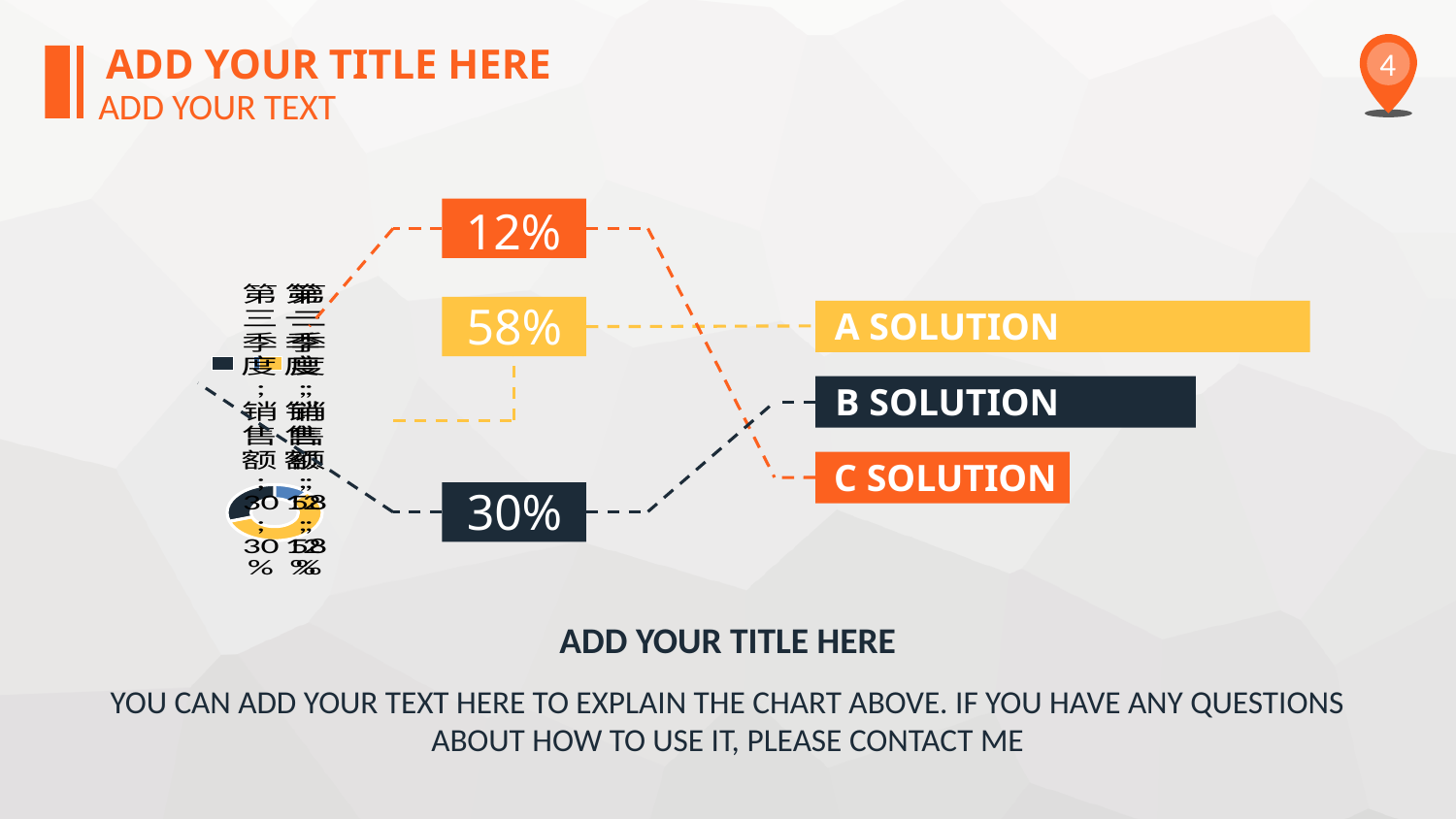
Which is larger, the 30% value or the 12% value? 30% What is the difference between the 30% and 12% values shown on the slide? 18% Which percentage callout is connected by a dashed line to A SOLUTION? 58% What is the smallest percentage shown in the callouts on the slide? 12% What do the three percentages 12%, 58% and 30% add up to? 100% What kind of chart is shown on the slide? Pie chart (doughnut) What is the difference between the 58% and 30% values shown on the slide? 28% How many slices does the doughnut chart have? 3 Which percentage callout is connected by a dashed line to C SOLUTION? 12% What is the largest percentage shown in the callouts on the slide? 58% Is the 58% value greater or less than 50%? greater